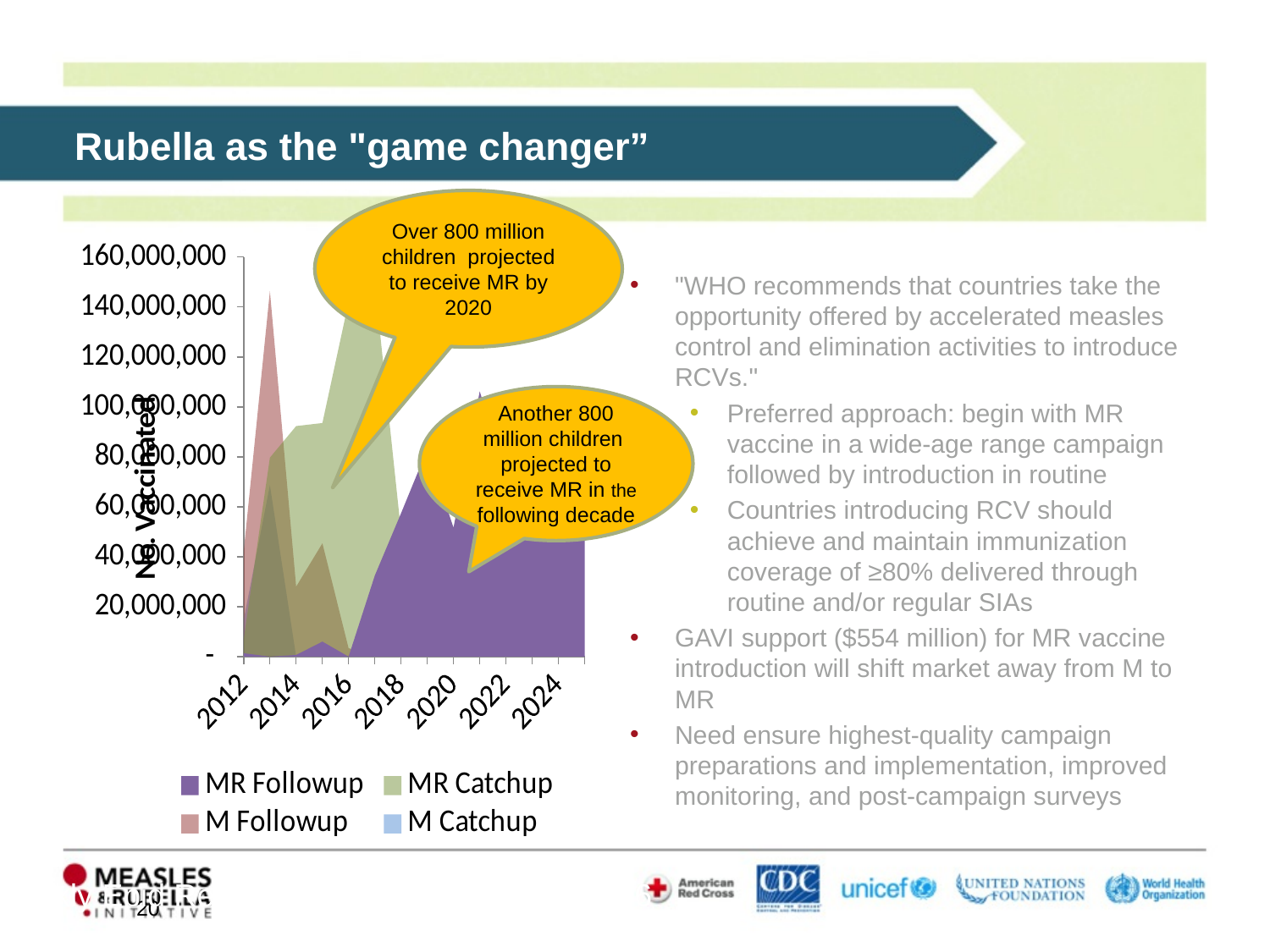
What is the first year shown on the chart's x axis? 2012 How many year labels are shown along the chart's x axis? 7 What is the highest value shown on the chart's vertical axis? 160,000,000 What is the label on the chart's vertical axis? No. Vaccinated What kind of chart is shown on the slide? Area chart Is the value for MR Followup in 2024 greater or less than 100,000,000? less Does the MR Followup series rise or fall between 2016 and 2019? rise Which series is shown in purple on the chart? MR Followup What is the last year shown on the chart's x axis? 2024 Is the value for MR Followup in 2024 greater or less than 40,000,000? greater How many series does the chart legend list? 4 What are the four series listed in the chart legend? MR Followup, MR Catchup, M Followup, M Catchup